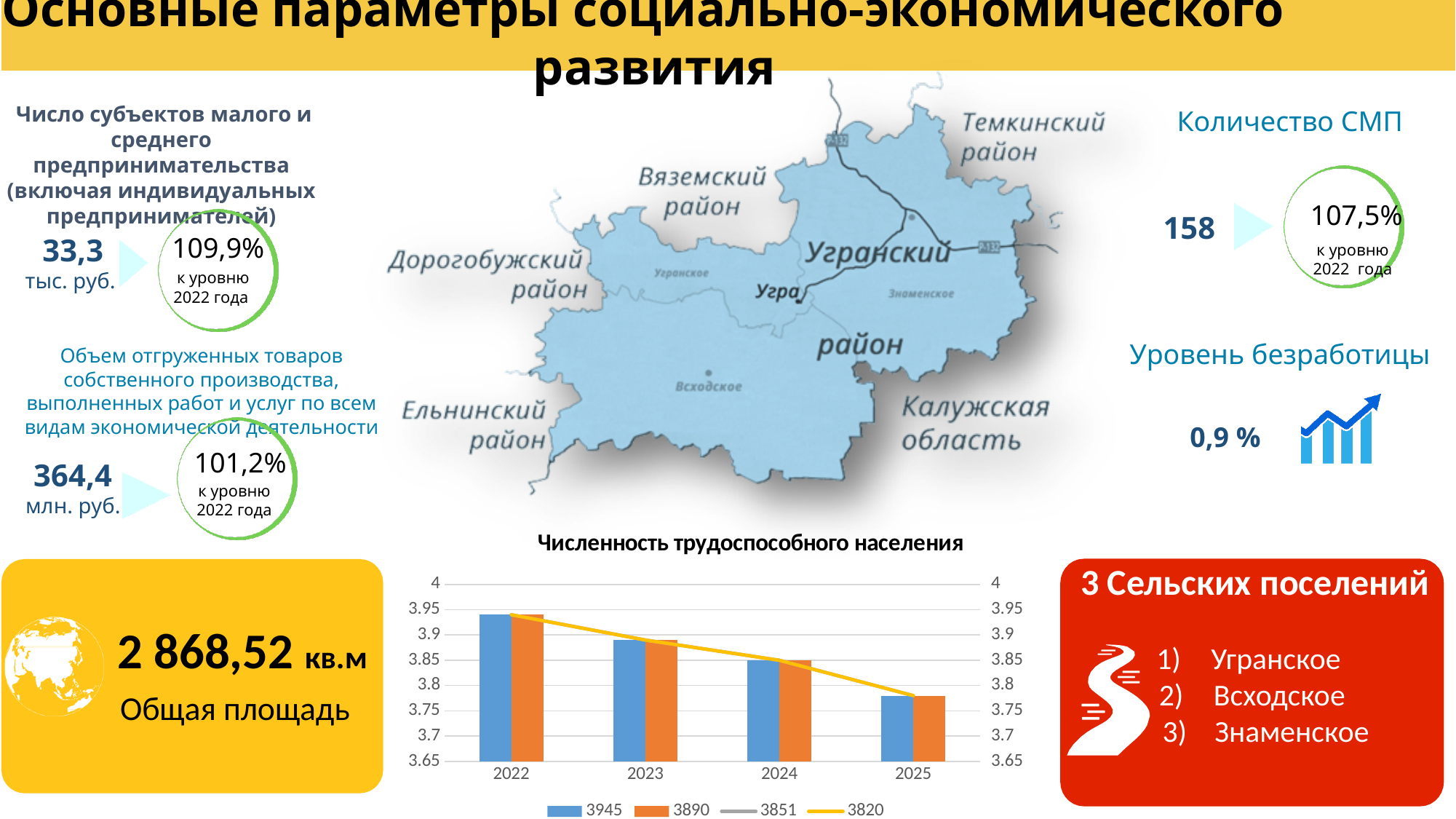
What is the title of the chart at the bottom centre of the slide? Численность трудоспособного населения What kind of chart is used for 'Численность трудоспособного населения'? combination bar and line chart In the 'Численность трудоспособного населения' chart, which year has the larger blue bar, 2022 or 2025? 2022 Which year has the highest bars in the 'Численность трудоспособного населения' chart? 2022 In the 'Численность трудоспособного населения' chart, is the blue bar for 2022 greater or less than 3.9? greater In the 'Численность трудоспособного населения' chart, do the values rise or fall from 2022 to 2025? fall What is the first legend entry of the 'Численность трудоспособного населения' chart? 3945 In the 'Численность трудоспособного населения' chart, is the orange bar for 2024 greater or less than 3.9? less How many years are shown on the x axis of the 'Численность трудоспособного населения' chart? 4 Which year has the lowest bars in the 'Численность трудоспособного населения' chart? 2025 How many entries does the legend of the 'Численность трудоспособного населения' chart list? 4 In the 'Численность трудоспособного населения' chart, is the blue bar for 2025 greater or less than 3.8? less